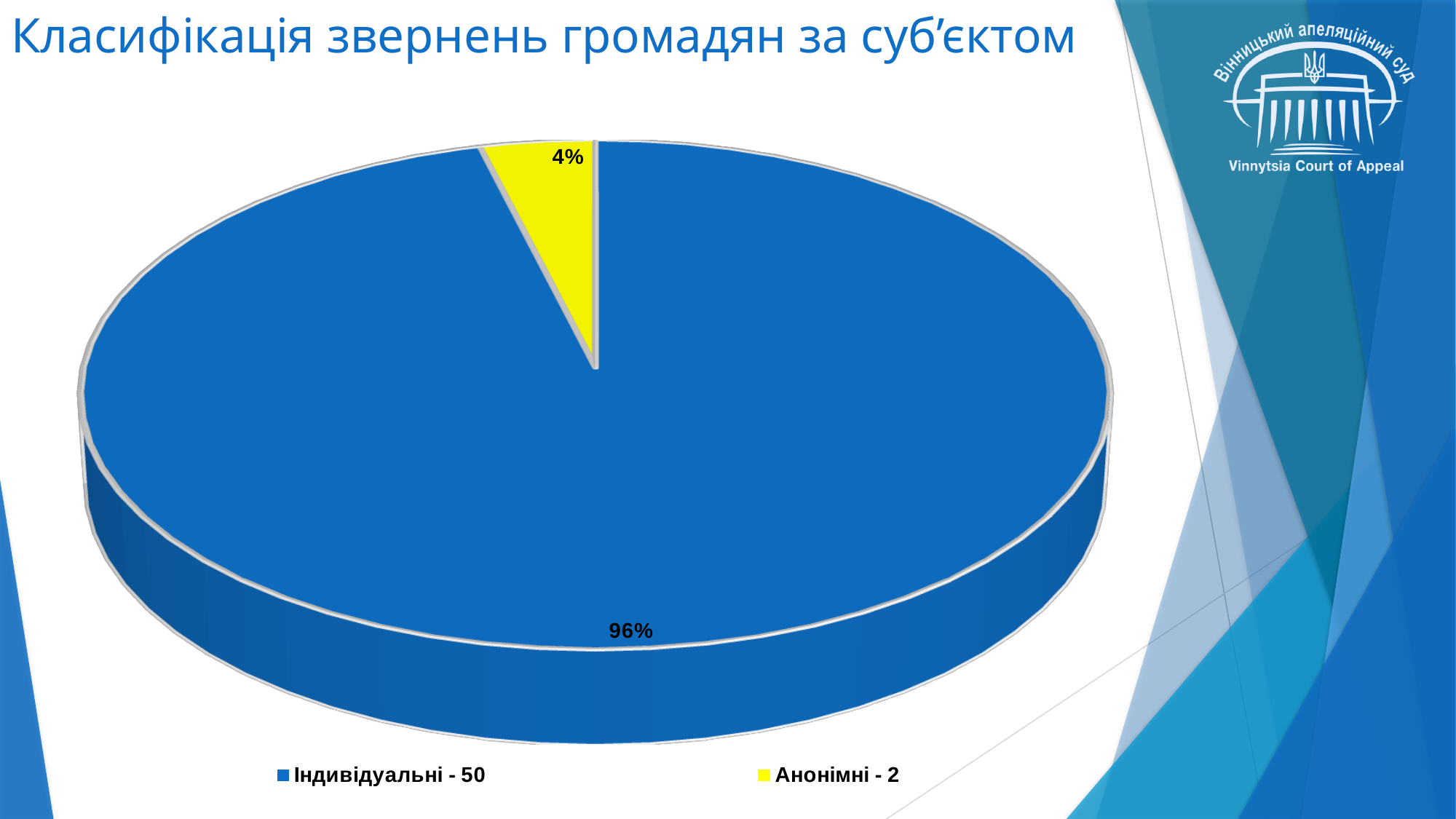
Which category has the smallest slice? Анонімні How many slices does the pie chart have? 2 What percentage share does the "Індивідуальні" slice have? 96% What is the difference in percentage points between the "Індивідуальні" and "Анонімні" slices? 92 What is the title of the chart? Класифікація звернень громадян за суб’єктом What colour is the "Анонімні" slice? yellow What kind of chart is shown on the slide? pie chart Which is larger, the "Індивідуальні" slice or the "Анонімні" slice? Індивідуальні What percentage share does the "Анонімні" slice have? 4% What count is shown in the legend for "Анонімні"? 2 What count is shown in the legend for "Індивідуальні"? 50 Which category has the largest slice? Індивідуальні